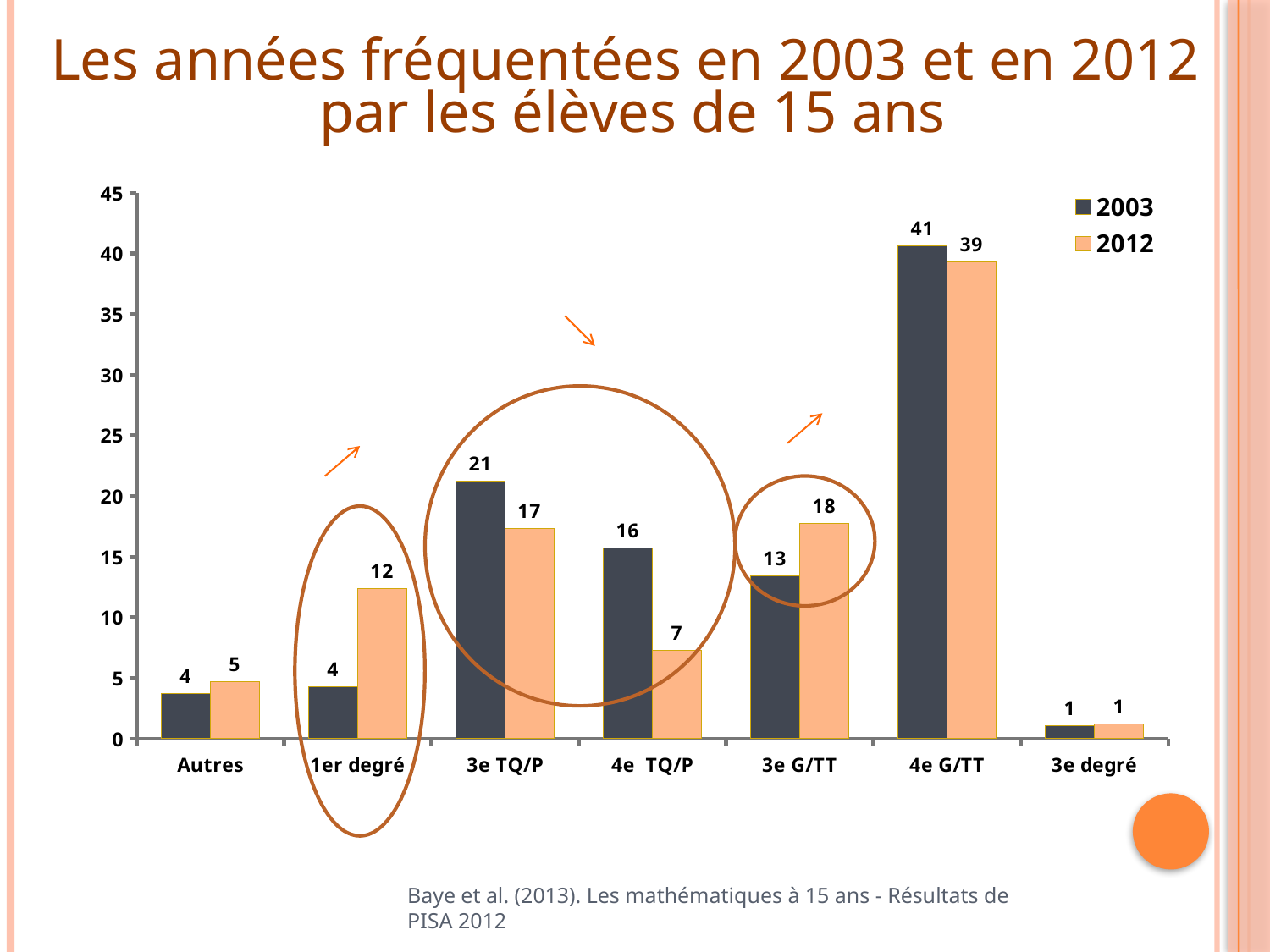
How many categories are shown on the x axis? 7 Which series is shown in orange in the legend? 2012 What kind of chart is shown on the slide? Bar chart What is the value for 4e TQ/P in the 2012 series? 7 What is the value for 1er degré in the 2012 series? 12 Which category has the lowest value in the 2012 series? 3e degré What is the value for 3e G/TT in the 2003 series? 13 Which category has the highest value in the 2003 series? 4e G/TT How many series does the legend list? 2 What is the difference between the 2012 and 2003 values for 1er degré? 8 What is the difference between the 2003 and 2012 values for 3e TQ/P? 4 Which is larger for 3e G/TT: the 2003 value or the 2012 value? 2012